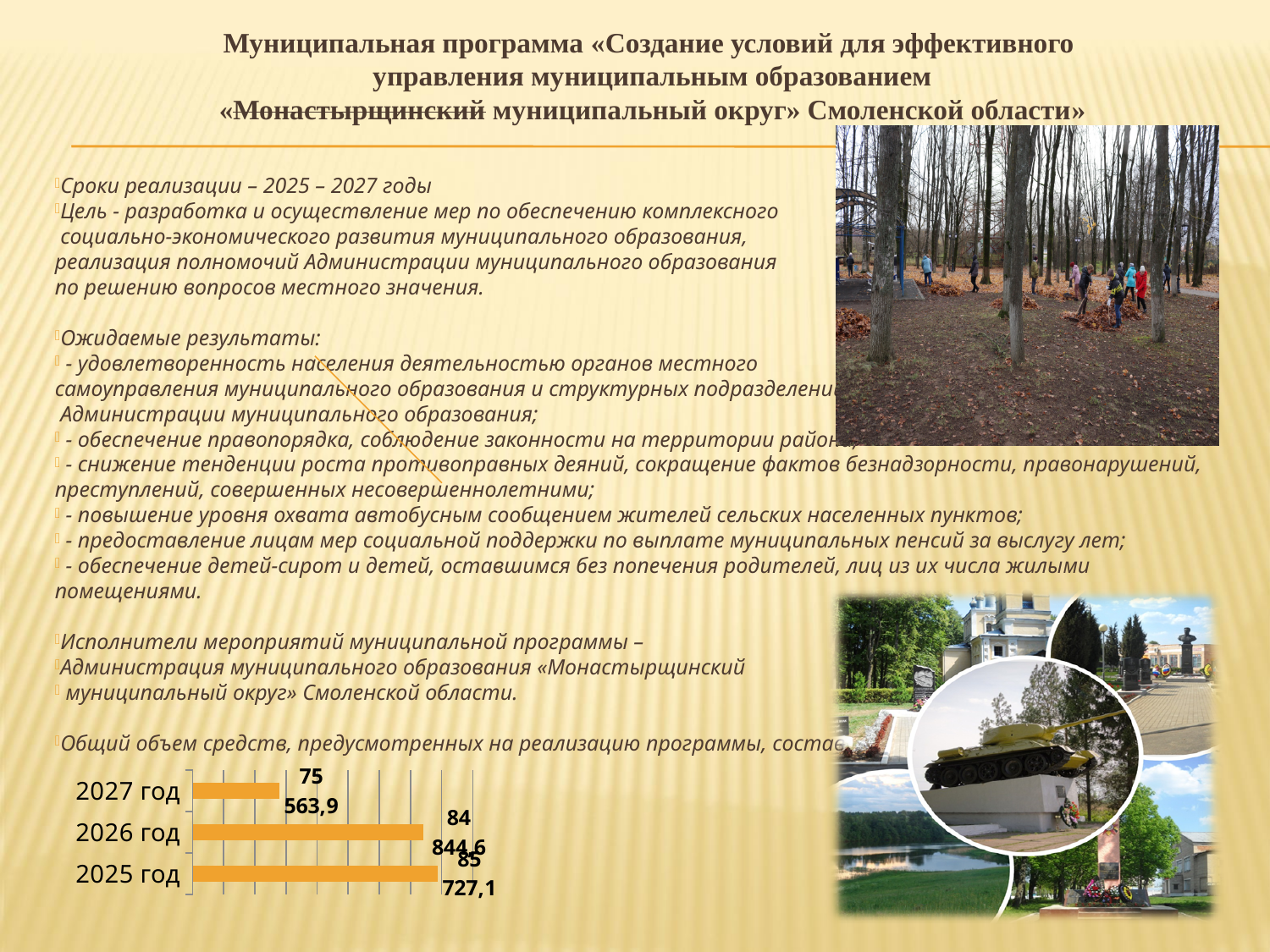
How many categories (years) are shown in the bar chart? 3 What is the difference between the values for 2025 год and 2026 год in the bar chart? 882,5 What is the value shown for 2026 год in the bar chart? 84 844,6 What is the value shown for 2025 год in the bar chart? 85 727,1 Which year has the lowest value in the bar chart? 2027 год What is the value shown for 2027 год in the bar chart? 75 563,9 Which is larger in the bar chart, the value for 2026 год or the value for 2027 год? 2026 год What is the difference between the values for 2026 год and 2027 год in the bar chart? 9 280,7 What is the difference between the values for 2025 год and 2027 год in the bar chart? 10 163,2 Which year has the highest value in the bar chart? 2025 год What type of chart is shown at the bottom of the slide? bar chart Do the values in the bar chart rise or fall from 2025 год to 2027 год? fall